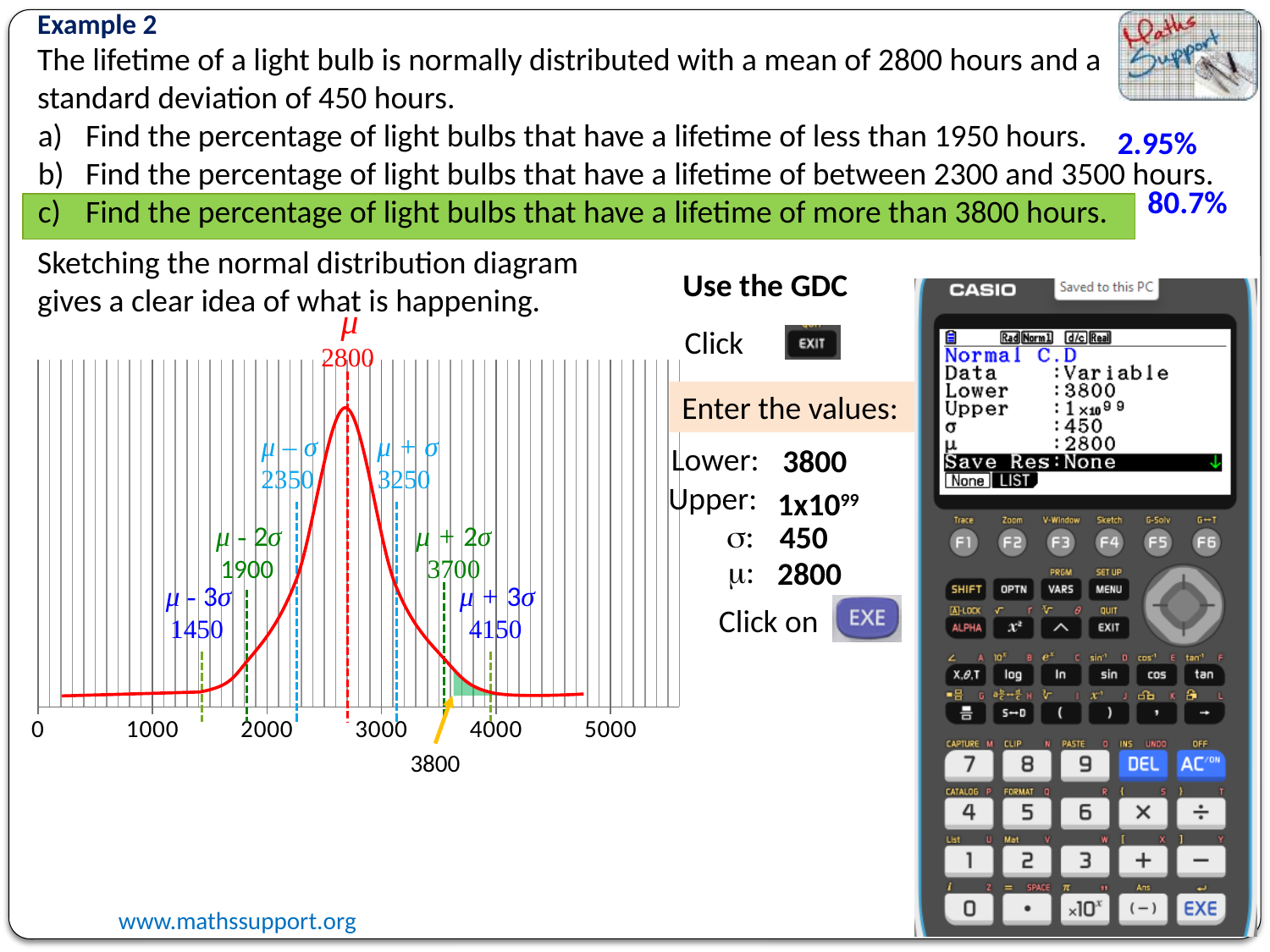
On the normal distribution diagram, how many dashed vertical lines mark labelled values (μ and the σ positions)? 7 On the normal distribution diagram, what value is labelled at μ + 2σ? 3700 What kind of chart is the normal distribution diagram on the slide? line chart On the normal distribution diagram, what value is labelled at μ + 3σ? 4150 On the normal distribution diagram, what is the difference between the values labelled at μ + σ and μ − σ? 900 On the normal distribution diagram, what value is labelled at μ − 2σ? 1900 On the normal distribution diagram, what value is labelled at μ − 3σ? 1450 On the normal distribution diagram, what value is labelled at μ − σ? 2350 On the normal distribution diagram, what value is labelled at μ + σ? 3250 On the normal distribution diagram, what value is labelled at the mean μ? 2800 On the normal distribution diagram, at what x value does the shaded region under the curve begin? 3800 On the normal distribution diagram, does the curve rise or fall as x increases from 3000 to 4000? fall